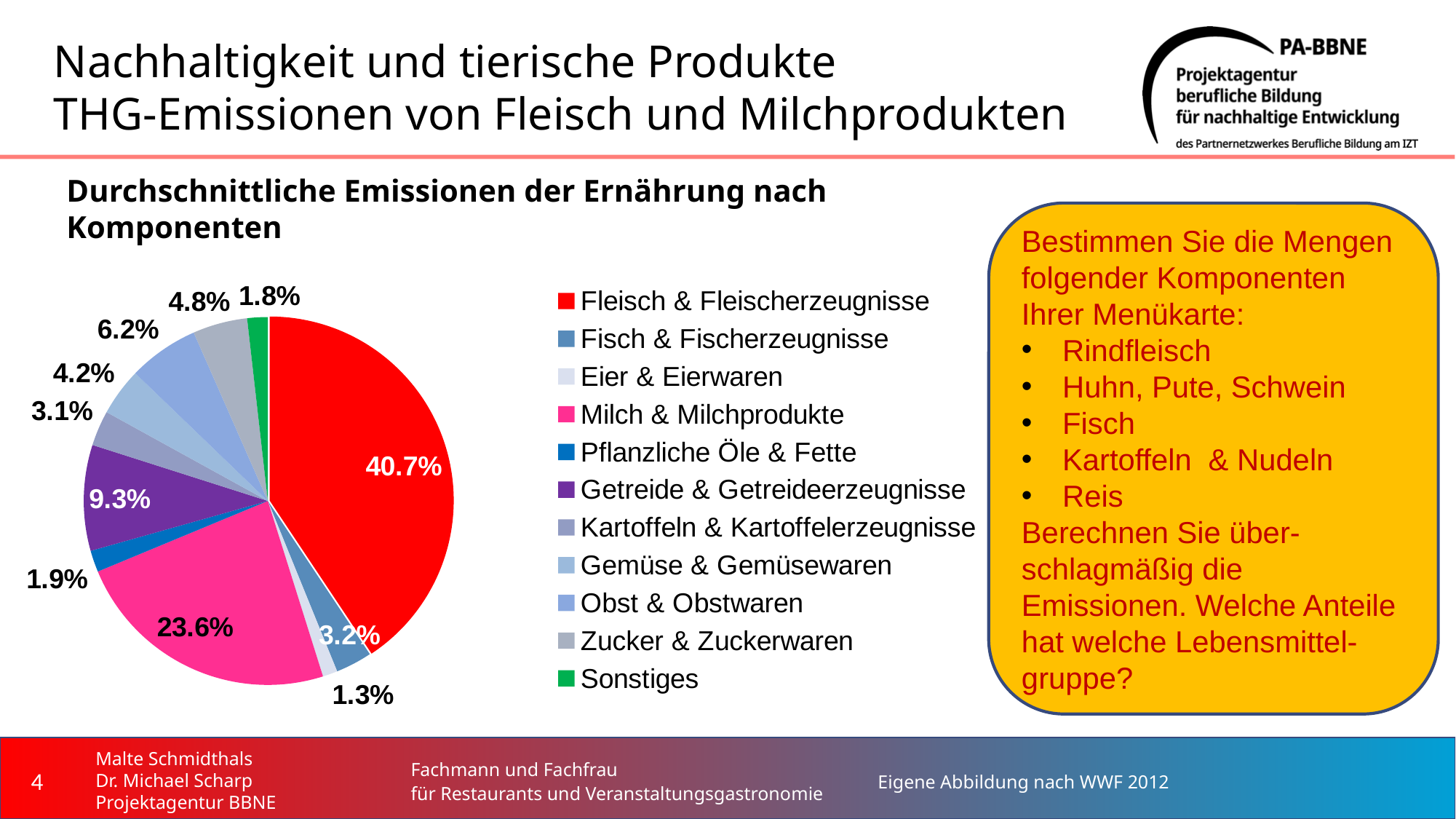
What share of the pie does Getreide & Getreideerzeugnisse have? 9.3% What is the title of the pie chart? Durchschnittliche Emissionen der Ernährung nach Komponenten What share of the pie does Fleisch & Fleischerzeugnisse have? 40.7% What share of the pie does Milch & Milchprodukte have? 23.6% What is the difference in percentage points between Fleisch & Fleischerzeugnisse and Milch & Milchprodukte? 17.1 How many categories does the legend of the pie chart list? 11 Which is larger, the share for Zucker & Zuckerwaren or the share for Gemüse & Gemüsewaren? Zucker & Zuckerwaren What type of chart is shown on the slide? pie chart Which category has the smallest slice of the pie? Eier & Eierwaren Which category has the largest slice of the pie? Fleisch & Fleischerzeugnisse What share of the pie does Eier & Eierwaren have? 1.3% What share of the pie does Obst & Obstwaren have? 6.2%